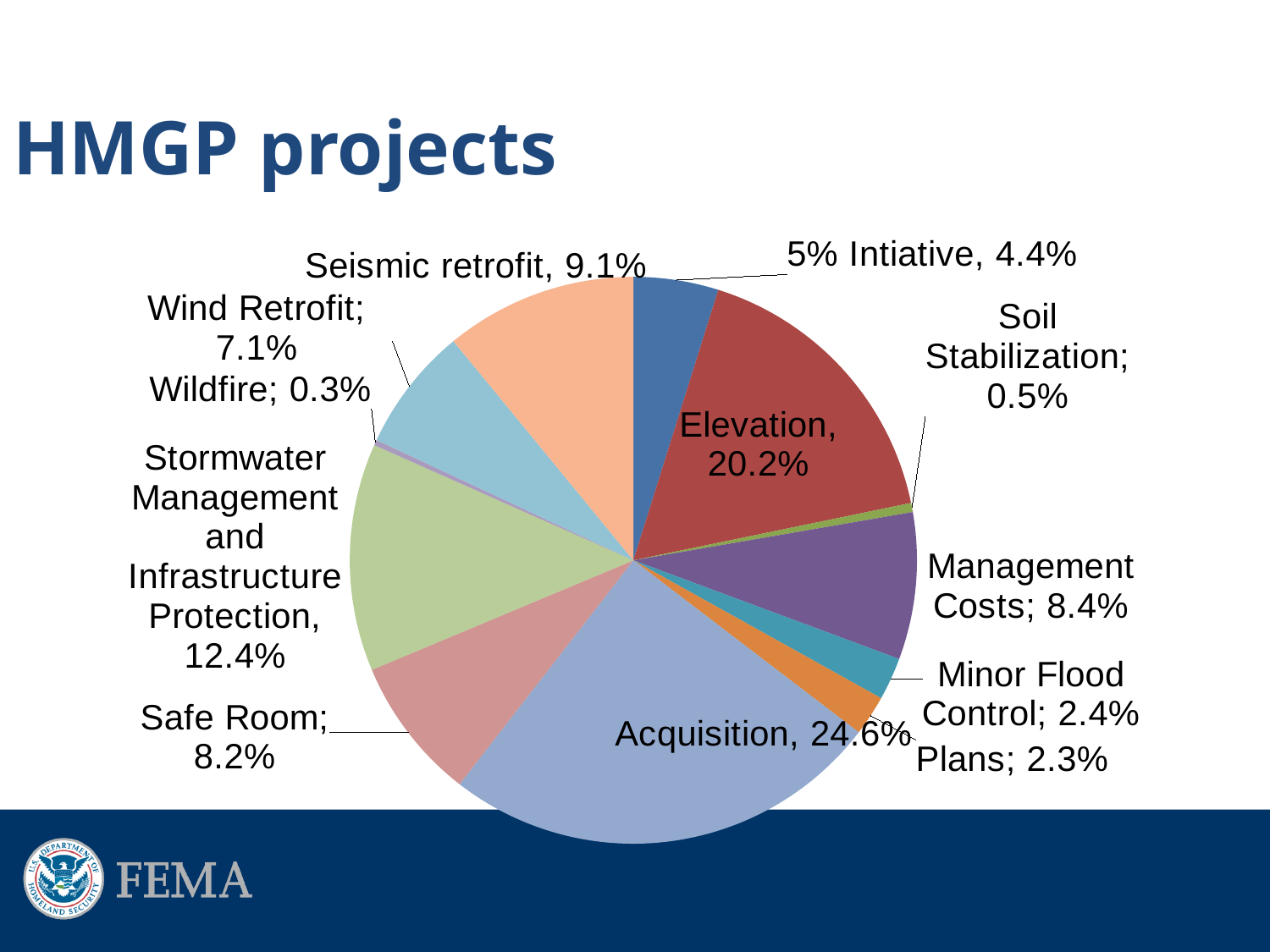
Which is larger, the share for Seismic retrofit or the share for Wind Retrofit? Seismic retrofit What share of HMGP projects is Stormwater Management and Infrastructure Protection? 12.4% What share of HMGP projects is Elevation? 20.2% What share of HMGP projects is Management Costs? 8.4% Which category has the largest share of HMGP projects? Acquisition Which category has the smallest share of HMGP projects? Wildfire What is the difference between the Acquisition share and the Elevation share? 4.4% What share of HMGP projects is Acquisition? 24.6% What is the difference between the Safe Room share and the Plans share? 5.9% What kind of chart is shown on the slide? Pie chart How many categories are shown in the pie chart? 12 What is the title of the slide containing the pie chart? HMGP projects